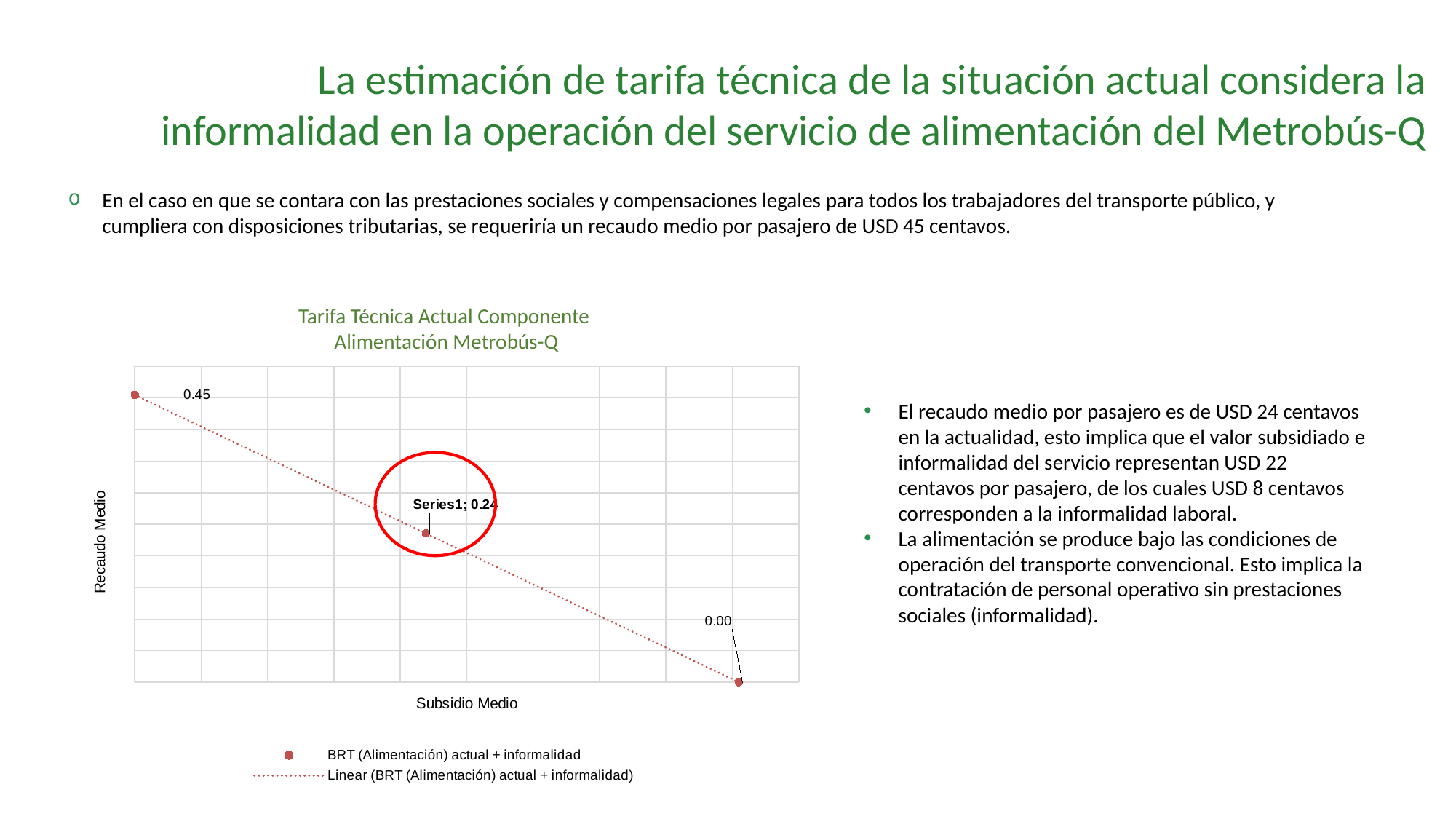
How many data points are plotted in the chart? 3 Do the plotted values rise or fall as Subsidio Medio increases along the x axis? fall What type of chart is shown on the slide? scatter chart What value is shown for the data point circled in red in the chart? 0.24 What is the highest data label value shown in the chart? 0.45 Which is larger in the chart: the point labelled 0.45 or the point labelled 0.24? 0.45 What is the difference between the highest labelled point (0.45) and the circled point (0.24) in the chart? 0.21 What is the title of the chart on the slide? Tarifa Técnica Actual Componente Alimentación Metrobús-Q What is the lowest data label value shown in the chart? 0.00 What is the label of the y axis in the chart? Recaudo Medio How many entries does the chart legend list? 2 What is the difference between the circled point (0.24) and the lowest point (0.00) in the chart? 0.24